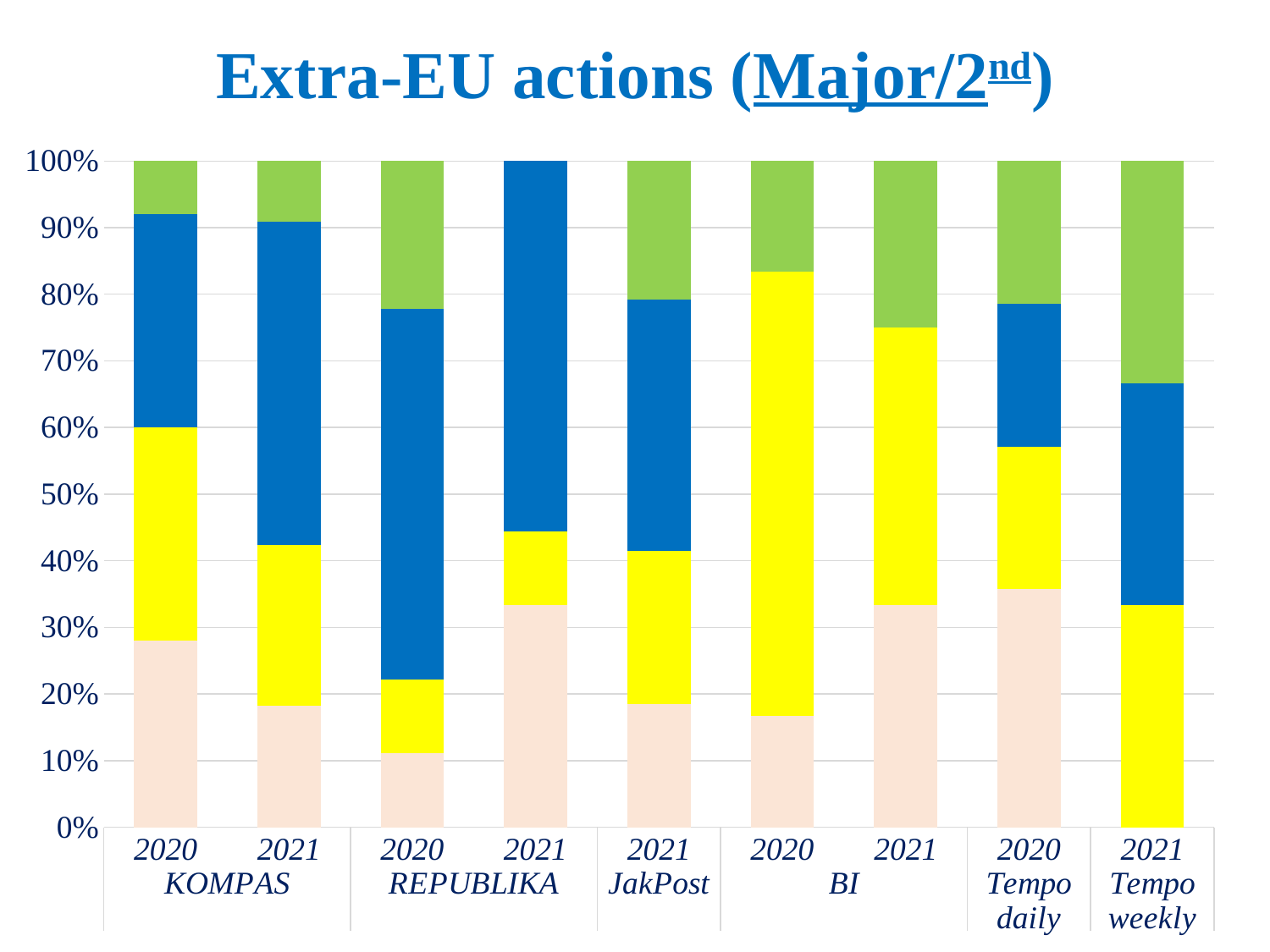
Is the top of the peach (bottom) segment for 2020 REPUBLIKA greater or less than 20%? less Is the top of the peach (bottom) segment for 2020 KOMPAS greater or less than 30%? less Is the top of the blue segment for 2021 Tempo weekly greater or less than 70%? less How many bars are plotted in the chart? 9 Which bar has the largest yellow segment? 2020 BI What is the highest value shown on the vertical axis? 100% Is the green segment larger for 2021 Tempo weekly or for 2020 KOMPAS? 2021 Tempo weekly What kind of chart is shown on the slide? stacked bar chart What is the title of the chart? Extra-EU actions (Major/2nd) Which bar has no green segment at the top? 2021 REPUBLIKA